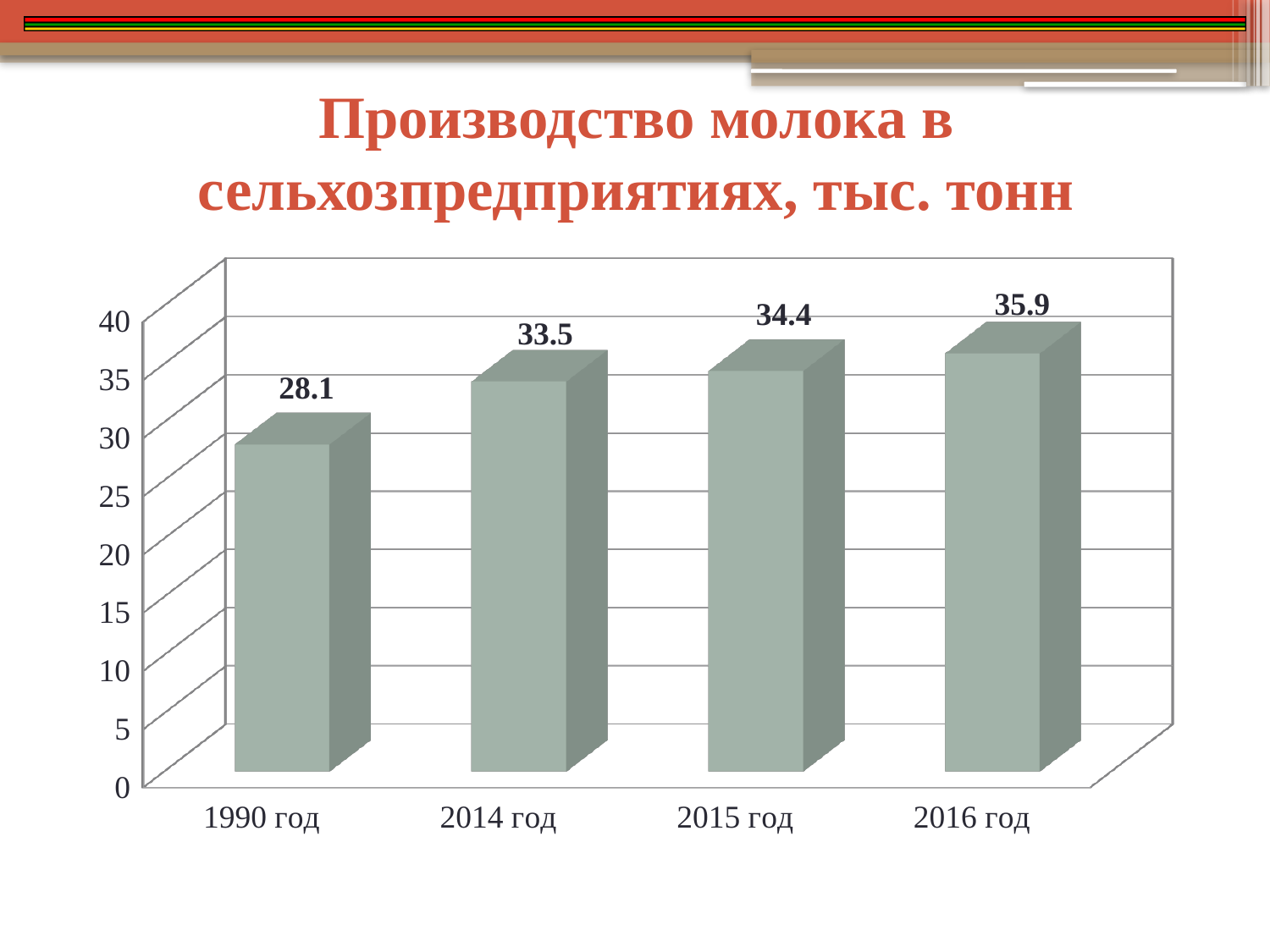
What is the milk production value for 2015 год? 34.4 What kind of chart is shown on the slide? bar chart What is the milk production value for 2016 год? 35.9 Which is larger, the value for 2014 год or the value for 1990 год? 2014 год What is the milk production value for 1990 год? 28.1 Do the values rise or fall from 1990 год to 2016 год? rise What is the difference between the values for 2016 год and 1990 год? 7.8 How many years are shown on the chart? 4 What is the difference between the values for 2015 год and 2014 год? 0.9 Which year has the highest milk production? 2016 год What is the milk production value for 2014 год? 33.5 Which year has the lowest milk production? 1990 год